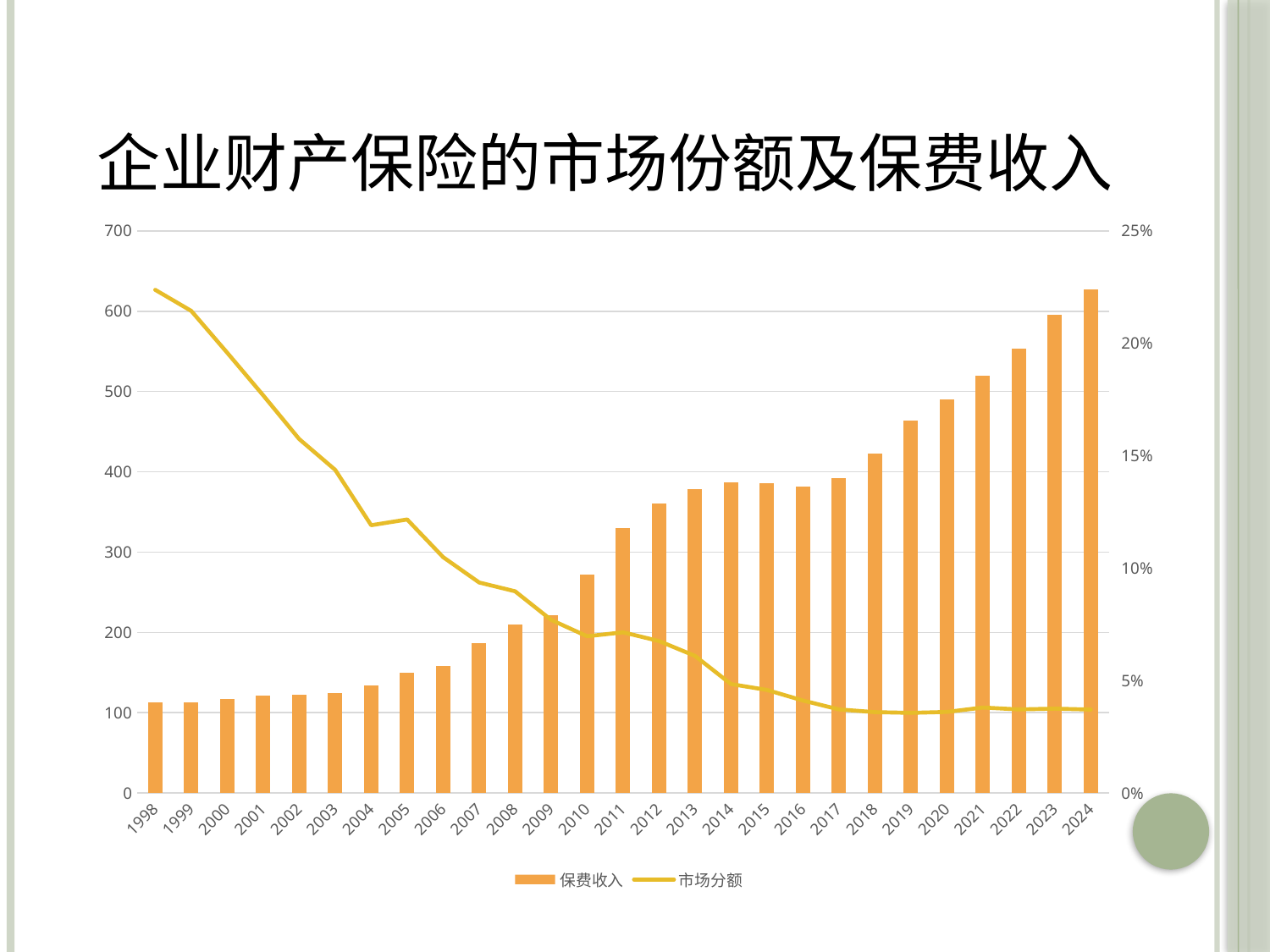
What is the title of the chart? 企业财产保险的市场份额及保费收入 How many years are shown on the x axis? 27 Is the 市场分额 value for 1998 greater or less than 20%? greater Does the 市场分额 line generally rise or fall from 1998 to 2024? fall Which year has the highest 保费收入 bar? 2024 In which year is the 市场分额 line at its highest? 1998 Which is larger, the 保费收入 bar for 2023 or for 2024? 2024 Is the 保费收入 value for 2024 greater or less than 600? greater Is the 市场分额 value for 2024 greater or less than 5%? less How many series does the legend list? 2 What kind of chart is shown on the slide? A combined bar and line chart